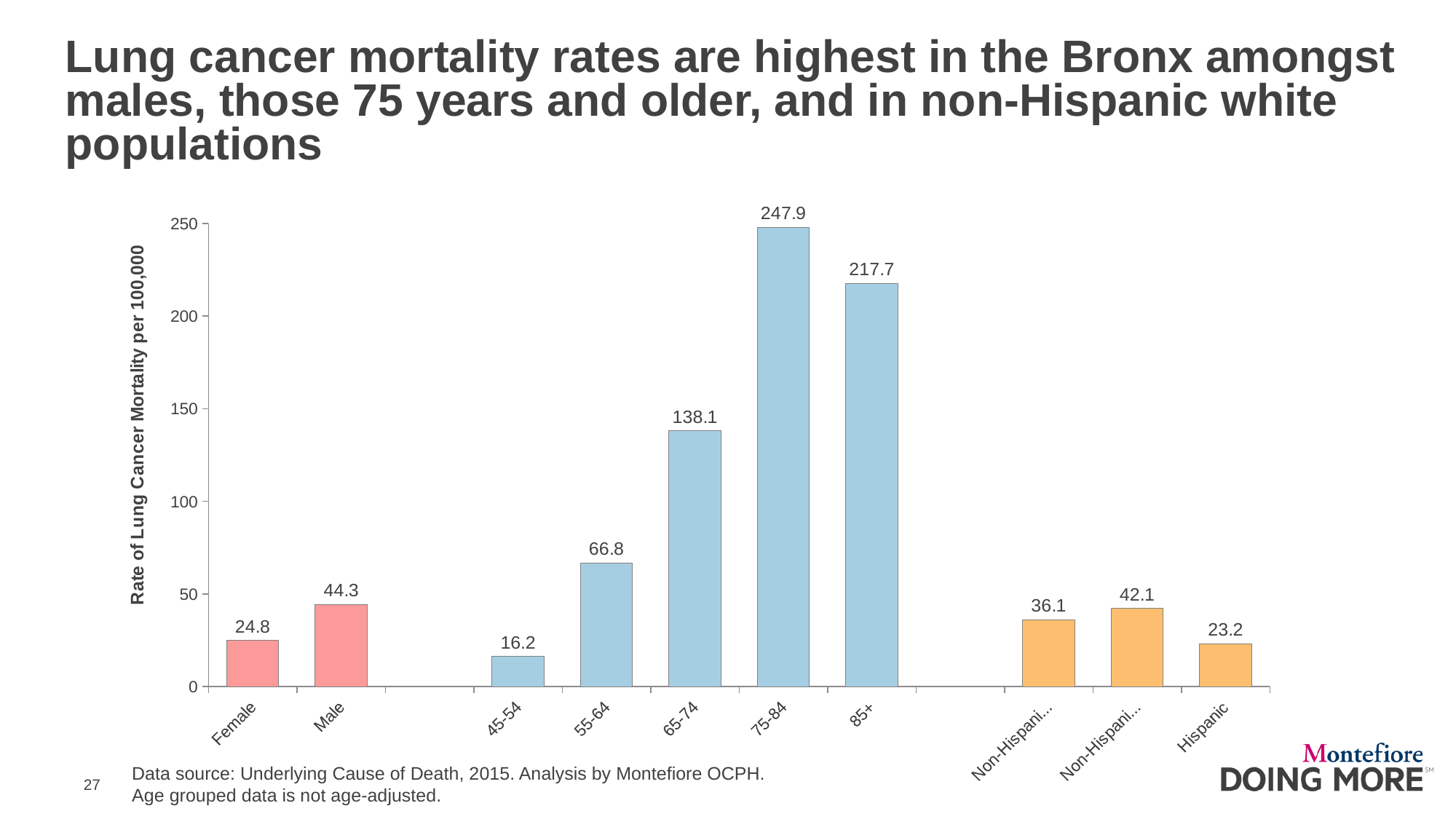
Which has a higher lung cancer mortality rate, Female or Male? Male What is the lung cancer mortality rate for Male? 44.3 Which category has the highest lung cancer mortality rate? 75-84 What is the difference between the Male and Female lung cancer mortality rates? 19.5 What is the lung cancer mortality rate for the 75-84 age group? 247.9 What is the lung cancer mortality rate for the 45-54 age group? 16.2 What is the difference between the 75-84 and 85+ lung cancer mortality rates? 30.2 What kind of chart is shown on the slide? Bar chart Is the value for the 65-74 age group greater or less than 100? greater What is the lung cancer mortality rate for Hispanic? 23.2 Which category has the lowest lung cancer mortality rate? 45-54 How many bars are plotted in the chart? 10